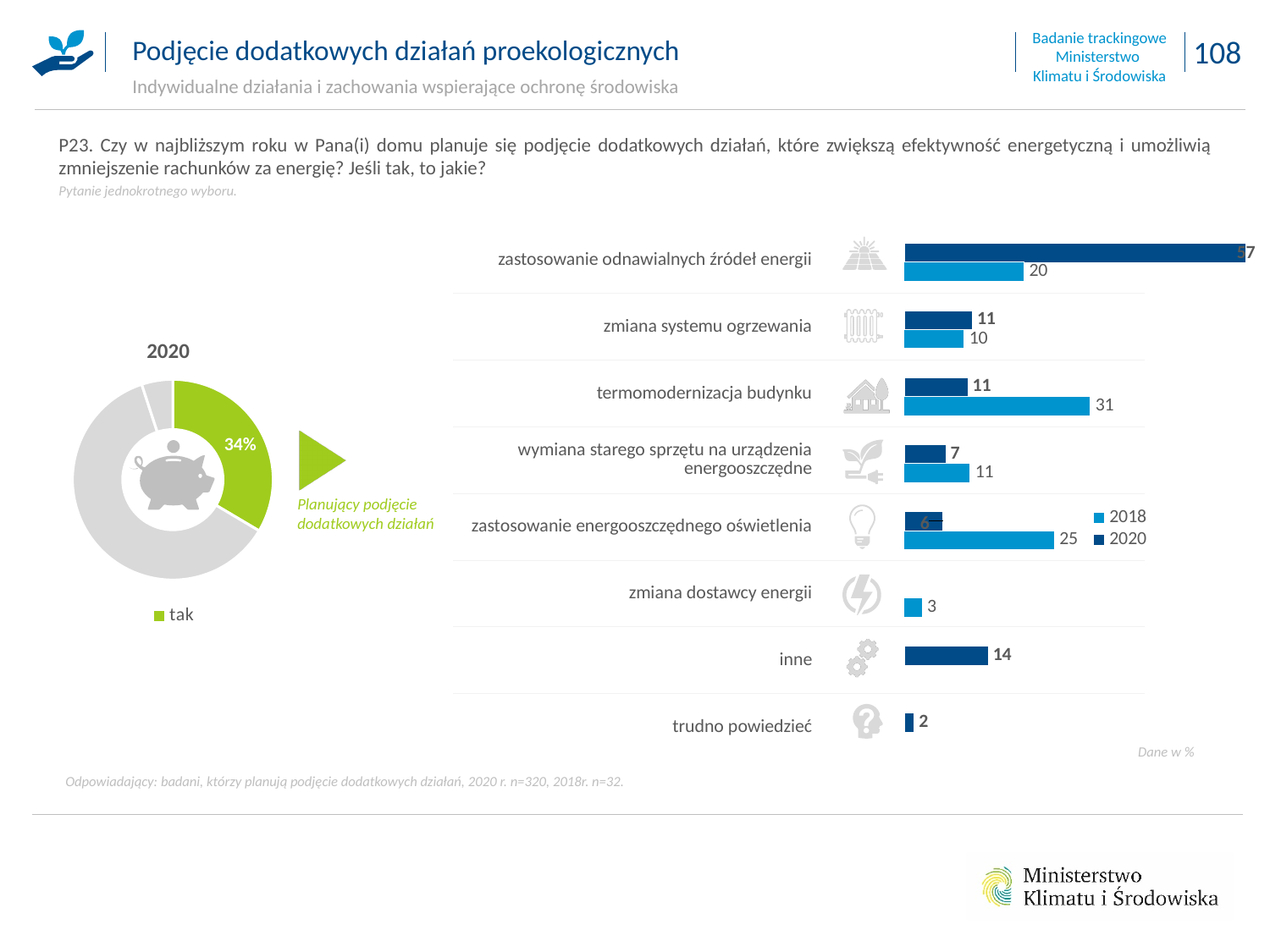
In the bar chart, what is the 2018 value for 'zastosowanie energooszczędnego oświetlenia'? 25 In the bar chart, for 'termomodernizacja budynku', which year has the larger value, 2018 or 2020? 2018 In the bar chart, what is the 2020 value for 'zastosowanie odnawialnych źródeł energii'? 57 In the donut chart labelled 2020, what share is shown for 'tak'? 34% In the bar chart, which category has the highest 2020 value? zastosowanie odnawialnych źródeł energii In the bar chart, what is the 2018 value for 'termomodernizacja budynku'? 31 How many categories are shown in the bar chart? 8 In the bar chart, what is the 2020 value for 'inne'? 14 What type of chart is the chart on the left of the slide? Donut (pie) chart In the bar chart, which category has the lowest 2018 value? zmiana dostawcy energii In the bar chart, how many series does the legend list? 2 In the bar chart, what is the difference between the 2020 and 2018 values for 'zastosowanie odnawialnych źródeł energii'? 37